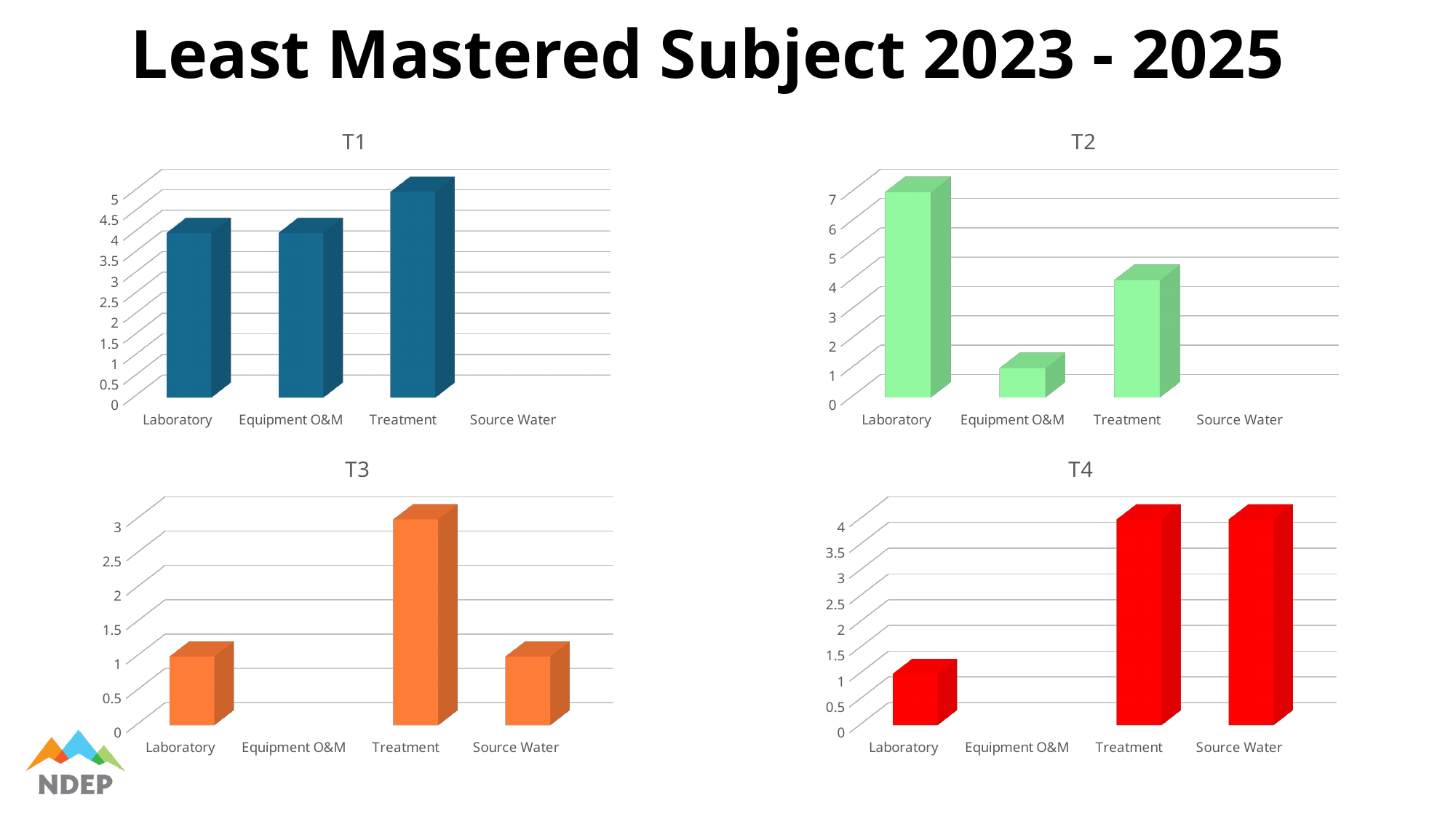
In the T1 chart, which category has the highest value? Treatment In the T2 chart, is the value for Equipment O&M greater or less than 3? less What type of chart is the T1 chart? bar chart In the T3 chart, what is the value for Treatment? 3 In the T2 chart, which is larger, Treatment or Equipment O&M? Treatment In the T4 chart, which is larger, Treatment or Laboratory? Treatment In the T3 chart, which category has the highest value? Treatment In the T4 chart, is the value for Laboratory greater or less than 2? less In the T1 chart, how many categories are shown on the x axis? 4 In the T2 chart, which category has the highest value? Laboratory In the T2 chart, what is the value for Laboratory? 7 How many charts are shown on the slide? 4